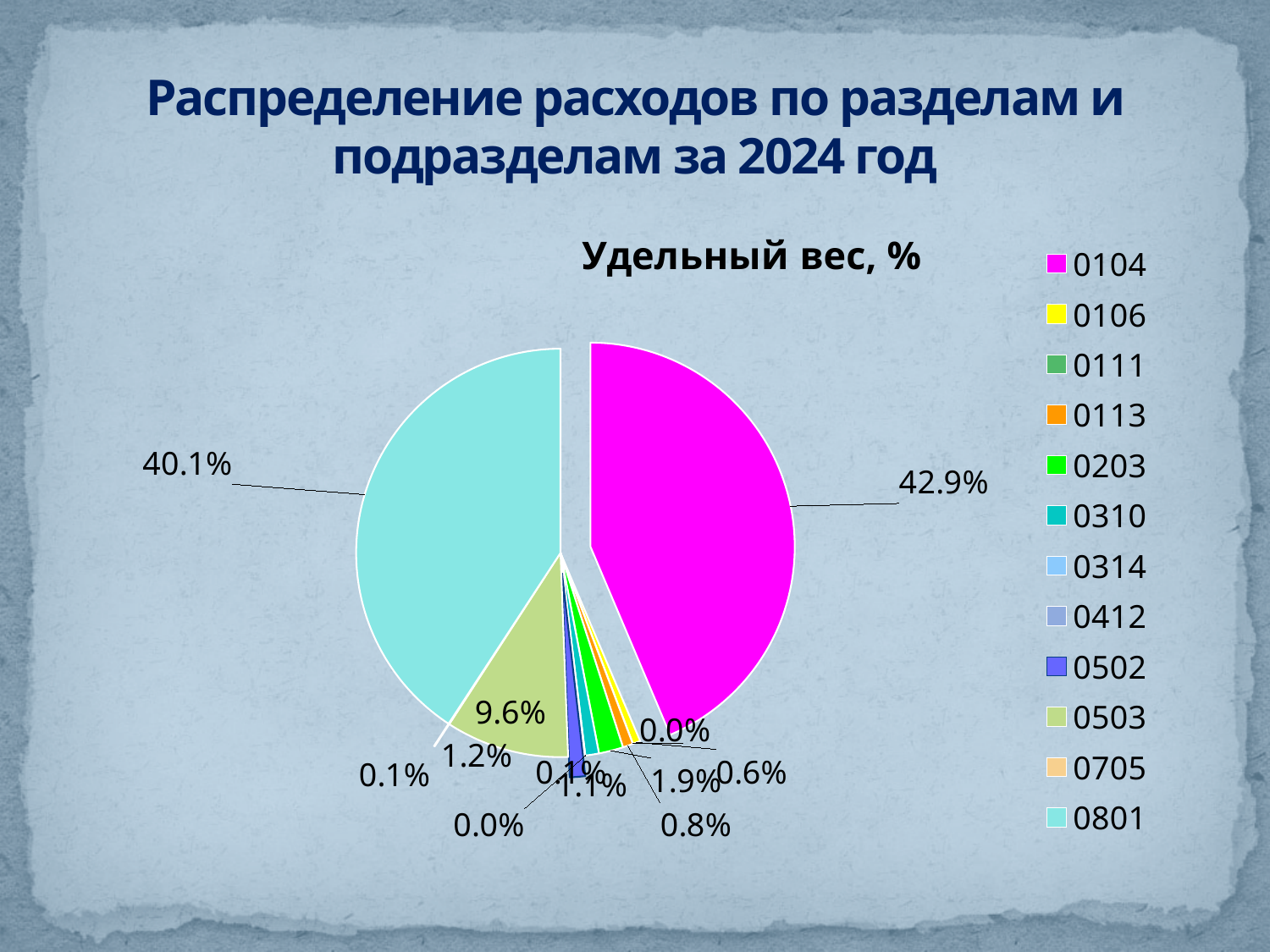
What is the difference in percentage points between the shares of 0104 and 0801? 2.8 Which is larger, the share for 0104 or the share for 0801? 0104 How many entries does the legend list? 12 Which category has the largest share of the pie? 0104 What colour is the slice for category 0104? magenta Which is larger, the share for 0503 or the share for 0801? 0801 What share of the pie does category 0503 have? 9.6% What share of the pie does category 0104 have? 42.9% What is the title of the chart? Удельный вес, % What kind of chart is shown on the slide? pie chart What is the combined share of categories 0104 and 0801? 83.0% What share of the pie does category 0801 have? 40.1%